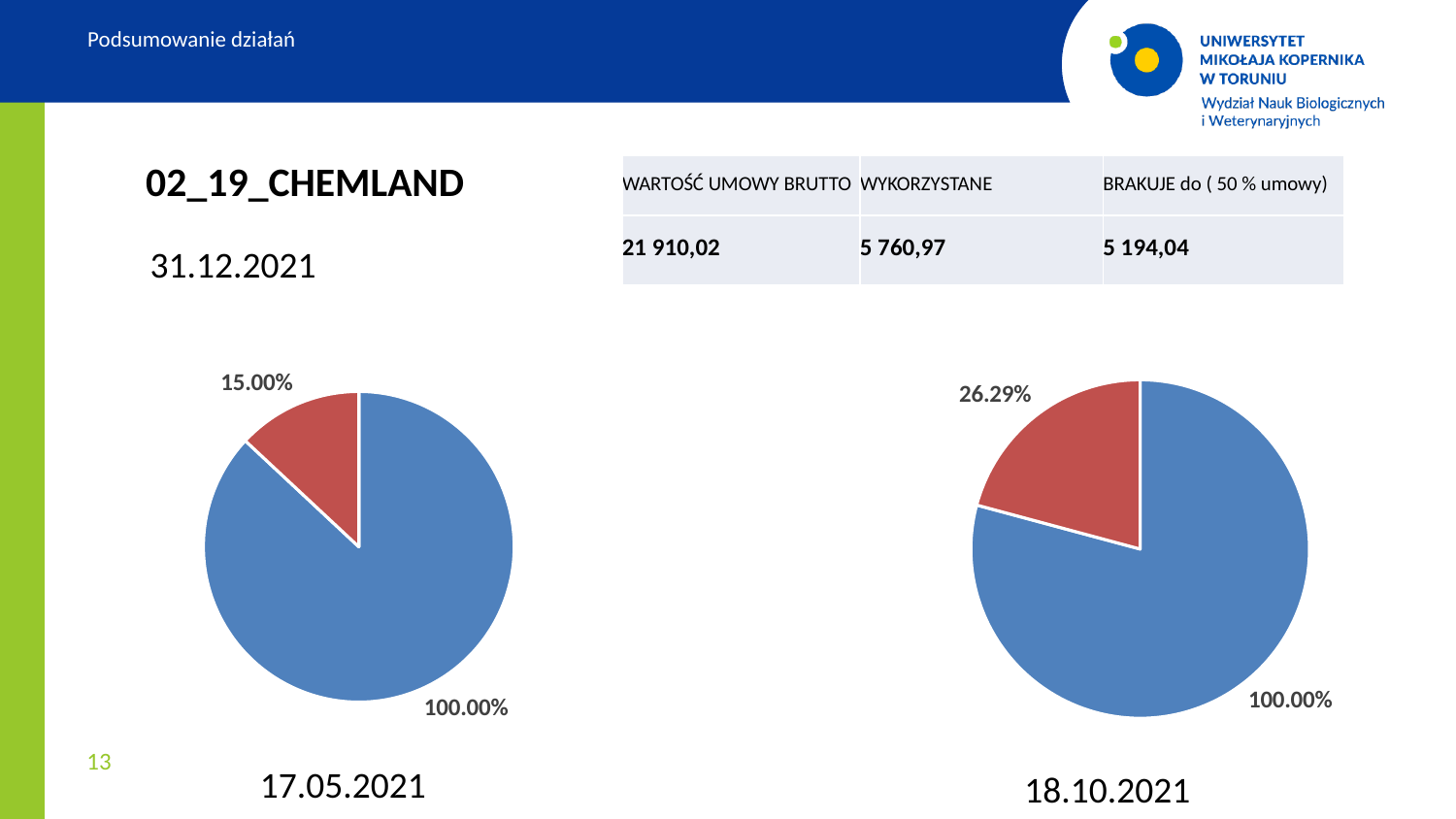
How many slices does the right pie chart (18.10.2021) have? 2 In the left pie chart (17.05.2021), which slice is the largest, the blue one or the red one? blue In the left pie chart (17.05.2021), what value is printed next to the red slice? 15.00% What is the difference between the red slice label in the right pie chart (26.29%) and the red slice label in the left pie chart (15.00%)? 11.29% What kind of chart is shown on the left side of the slide, above the date 17.05.2021? pie chart In the right pie chart (18.10.2021), what value is printed next to the blue slice? 100.00% What kind of chart is shown on the right side of the slide, above the date 18.10.2021? pie chart How many slices does the left pie chart (17.05.2021) have? 2 In the left pie chart (17.05.2021), what value is printed next to the blue slice? 100.00% Which pie chart has the larger red slice, the one dated 17.05.2021 or the one dated 18.10.2021? 18.10.2021 What colour is the smaller slice in the right pie chart (18.10.2021)? red In the right pie chart (18.10.2021), what value is printed next to the red slice? 26.29%